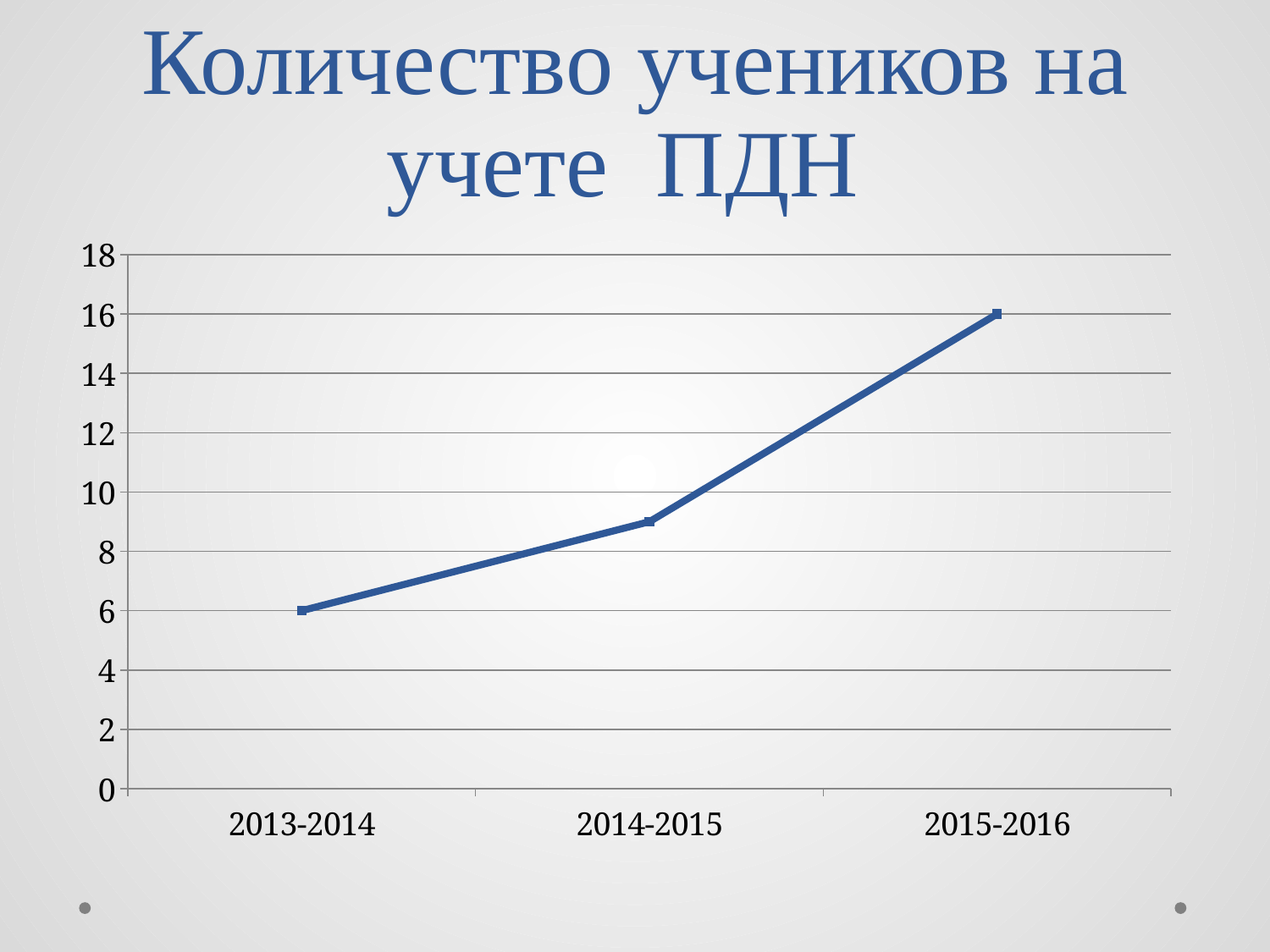
What type of chart is shown on the slide? line chart Which school year has the highest value? 2015-2016 Is the value for 2014-2015 greater or less than 10? less What is the value for 2015-2016? 16 What is the difference between the values for 2015-2016 and 2013-2014? 10 Do the values rise or fall from 2013-2014 to 2015-2016? rise What is the value for 2013-2014? 6 Is the value for 2014-2015 greater or less than 8? greater Which is larger, the value for 2014-2015 or the value for 2015-2016? 2015-2016 How many data points are plotted on the line? 3 Which school year has the lowest value? 2013-2014 What is the title of the chart? Количество учеников на учете ПДН